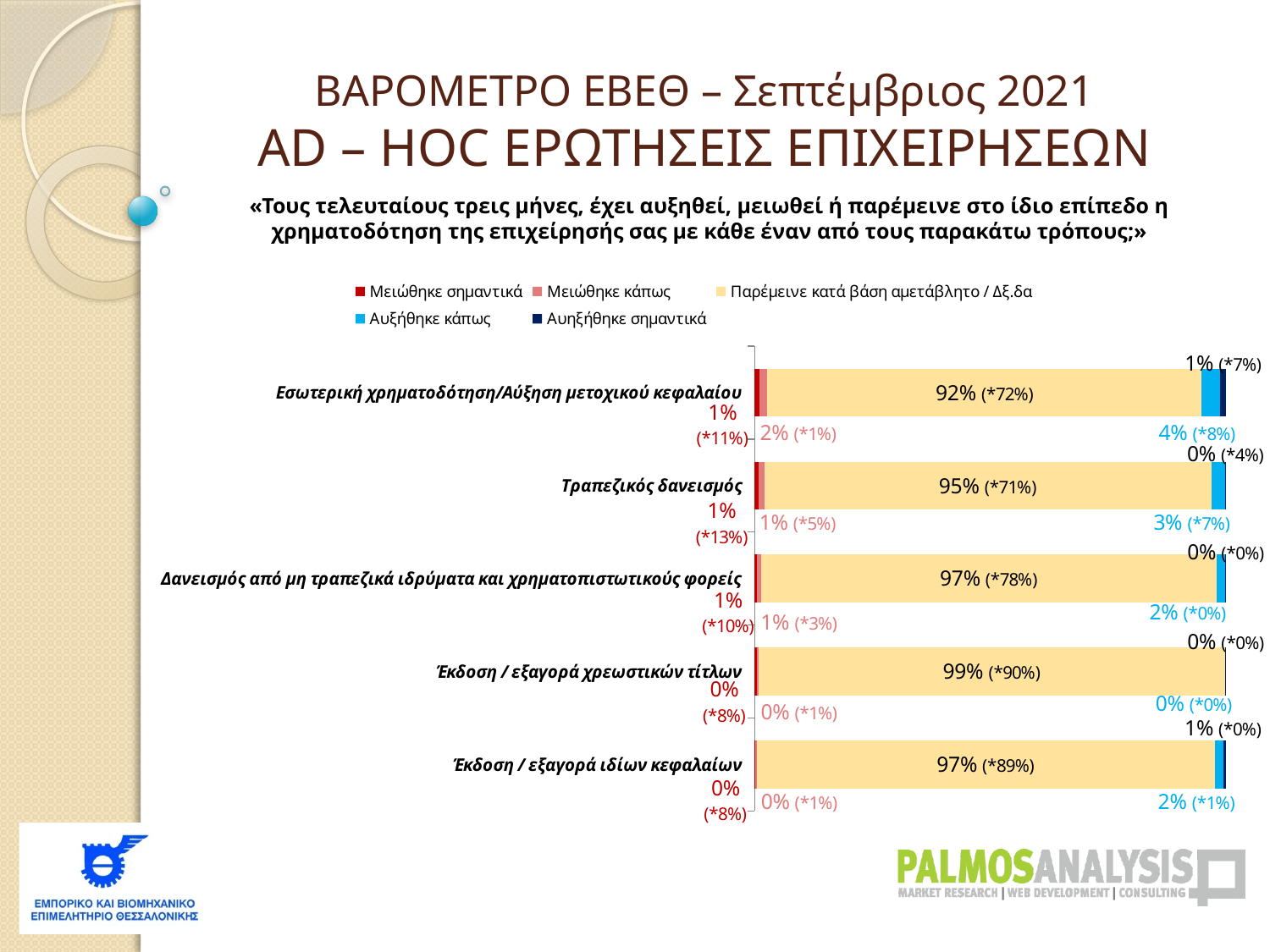
Which is larger: the "Αυξήθηκε κάπως" value for "Εσωτερική χρηματοδότηση/Αύξηση μετοχικού κεφαλαίου" or for "Τραπεζικός δανεισμός"? Εσωτερική χρηματοδότηση/Αύξηση μετοχικού κεφαλαίου How many categories (financing methods) are shown on the chart? 5 Which category has the lowest value for "Παρέμεινε κατά βάση αμετάβλητο / Δξ.δα"? Εσωτερική χρηματοδότηση/Αύξηση μετοχικού κεφαλαίου What is the difference between the "Παρέμεινε κατά βάση αμετάβλητο / Δξ.δα" values for "Έκδοση / εξαγορά χρεωστικών τίτλων" and "Εσωτερική χρηματοδότηση/Αύξηση μετοχικού κεφαλαίου"? 7% What is the previous-period value (shown in parentheses) of "Παρέμεινε κατά βάση αμετάβλητο / Δξ.δα" for "Τραπεζικός δανεισμός"? *71% What is the value of "Παρέμεινε κατά βάση αμετάβλητο / Δξ.δα" for "Τραπεζικός δανεισμός"? 95% What is the value of "Παρέμεινε κατά βάση αμετάβλητο / Δξ.δα" for "Έκδοση / εξαγορά χρεωστικών τίτλων"? 99% How many series does the legend list? 5 What is the value of "Μειώθηκε κάπως" for "Εσωτερική χρηματοδότηση/Αύξηση μετοχικού κεφαλαίου"? 2% Which category has the highest value for "Παρέμεινε κατά βάση αμετάβλητο / Δξ.δα"? Έκδοση / εξαγορά χρεωστικών τίτλων What is the value of "Αυξήθηκε κάπως" for "Εσωτερική χρηματοδότηση/Αύξηση μετοχικού κεφαλαίου"? 4% What kind of chart is shown on the slide? Stacked bar chart